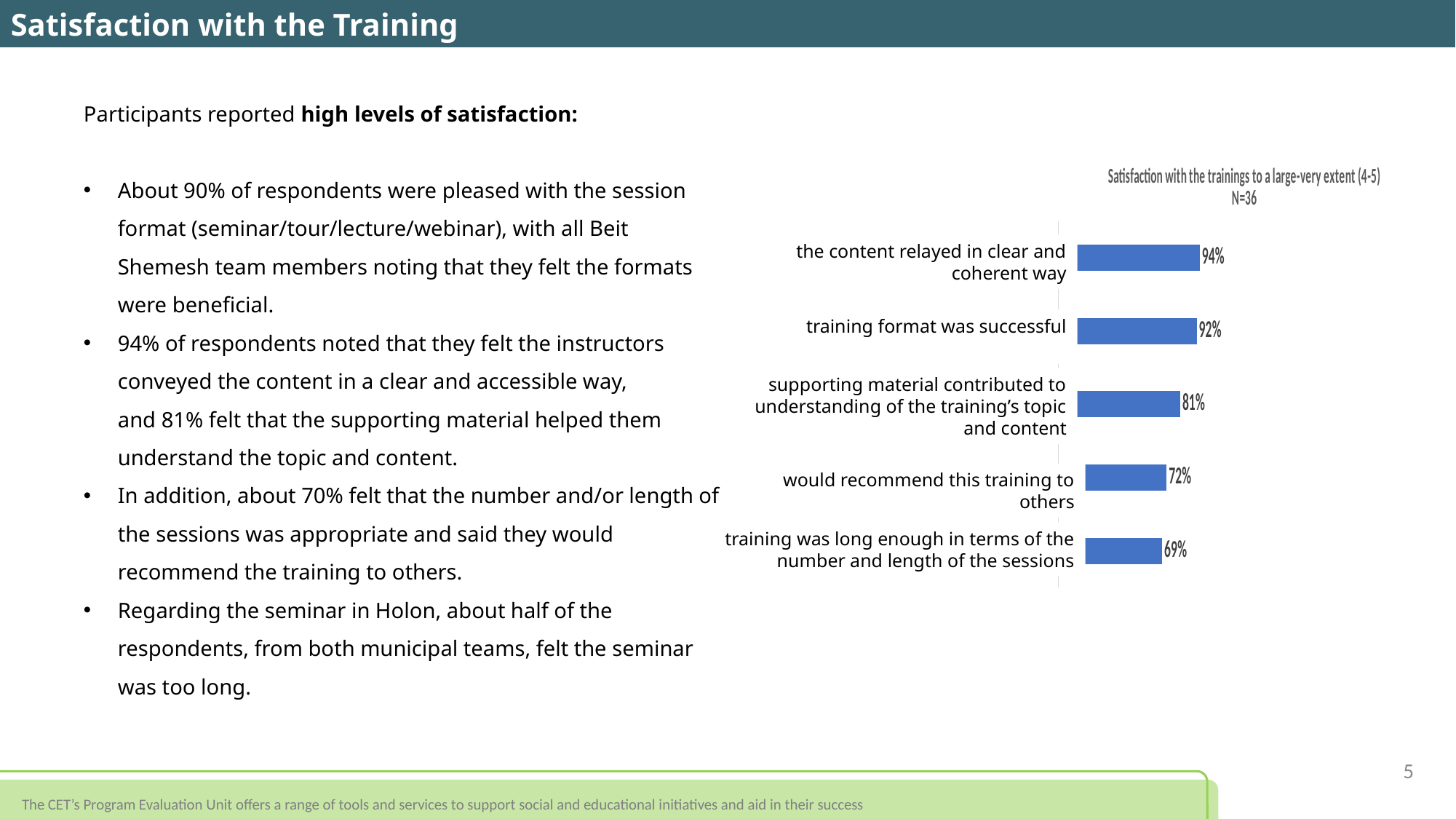
Which category has the lowest value in the chart? training was long enough in terms of the number and length of the sessions Which category has the highest value in the chart? the content relayed in clear and coherent way What is the sample size (N) stated in the chart title? N=36 How many categories are shown in the chart? 5 What is the value for 'training was long enough in terms of the number and length of the sessions'? 69% What percentage felt the supporting material contributed to understanding of the training's topic and content? 81% What is the difference between the value for 'the content relayed in clear and coherent way' and the value for 'would recommend this training to others'? 22% What percentage of respondents said the content was relayed in a clear and coherent way? 94% What kind of chart is shown on the slide? bar chart Which is larger: the value for 'supporting material contributed to understanding of the training's topic and content' or the value for 'would recommend this training to others'? supporting material contributed to understanding of the training's topic and content What percentage would recommend this training to others? 72% What is the value for 'training format was successful'? 92%